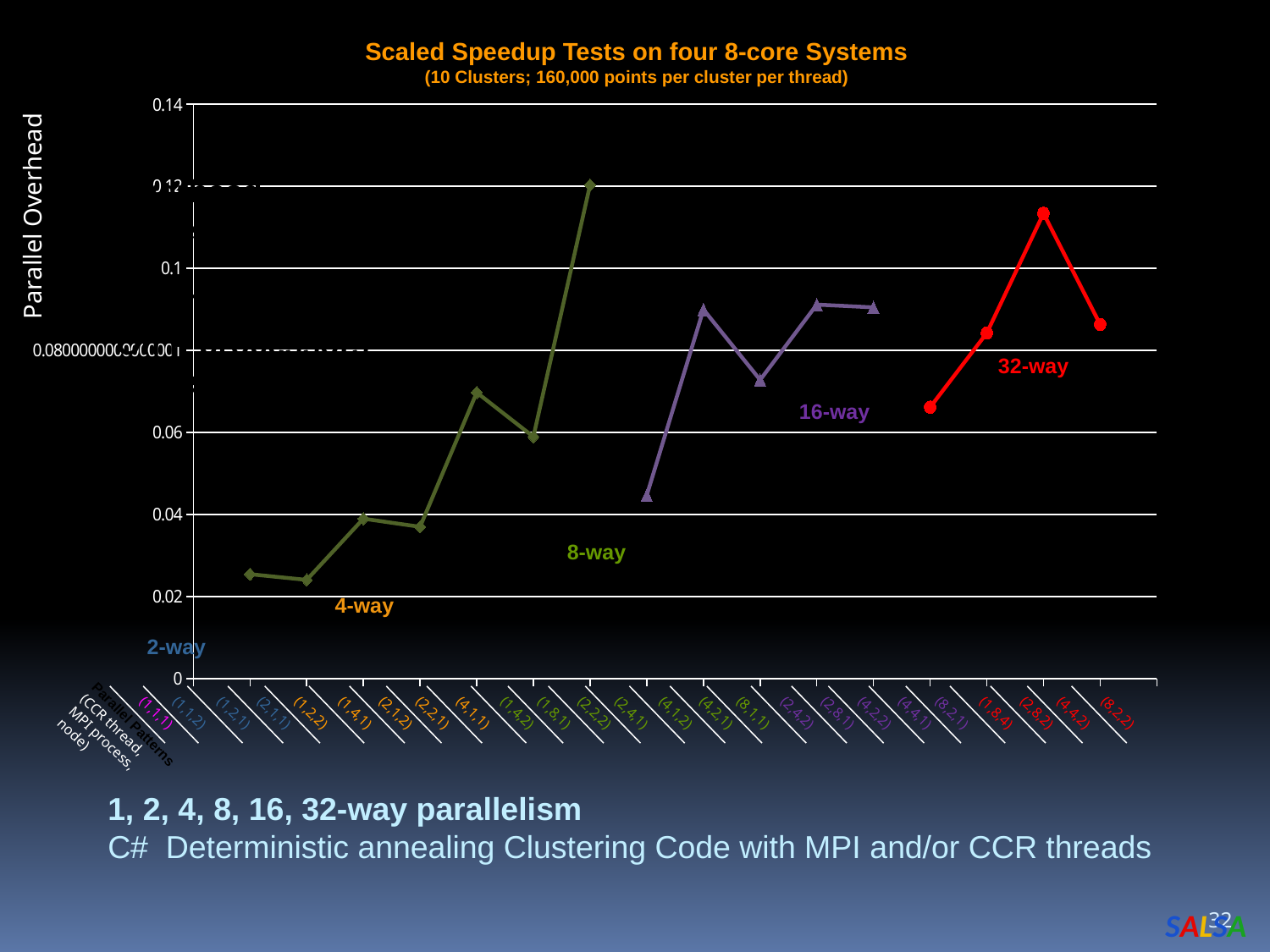
How many parallelism series (e.g. 2-way, 4-way) are labelled on the chart? 5 What is the label on the vertical axis of the chart? Parallel Overhead Is the peak value of the 8-way series greater or less than 0.1? greater What is the title of the chart? Scaled Speedup Tests on four 8-core Systems What kind of chart is shown on the slide? line chart Is the peak value of the 32-way series greater or less than 0.1? greater Is the value for the first 16-way point, (4,1,2), greater or less than 0.06? less